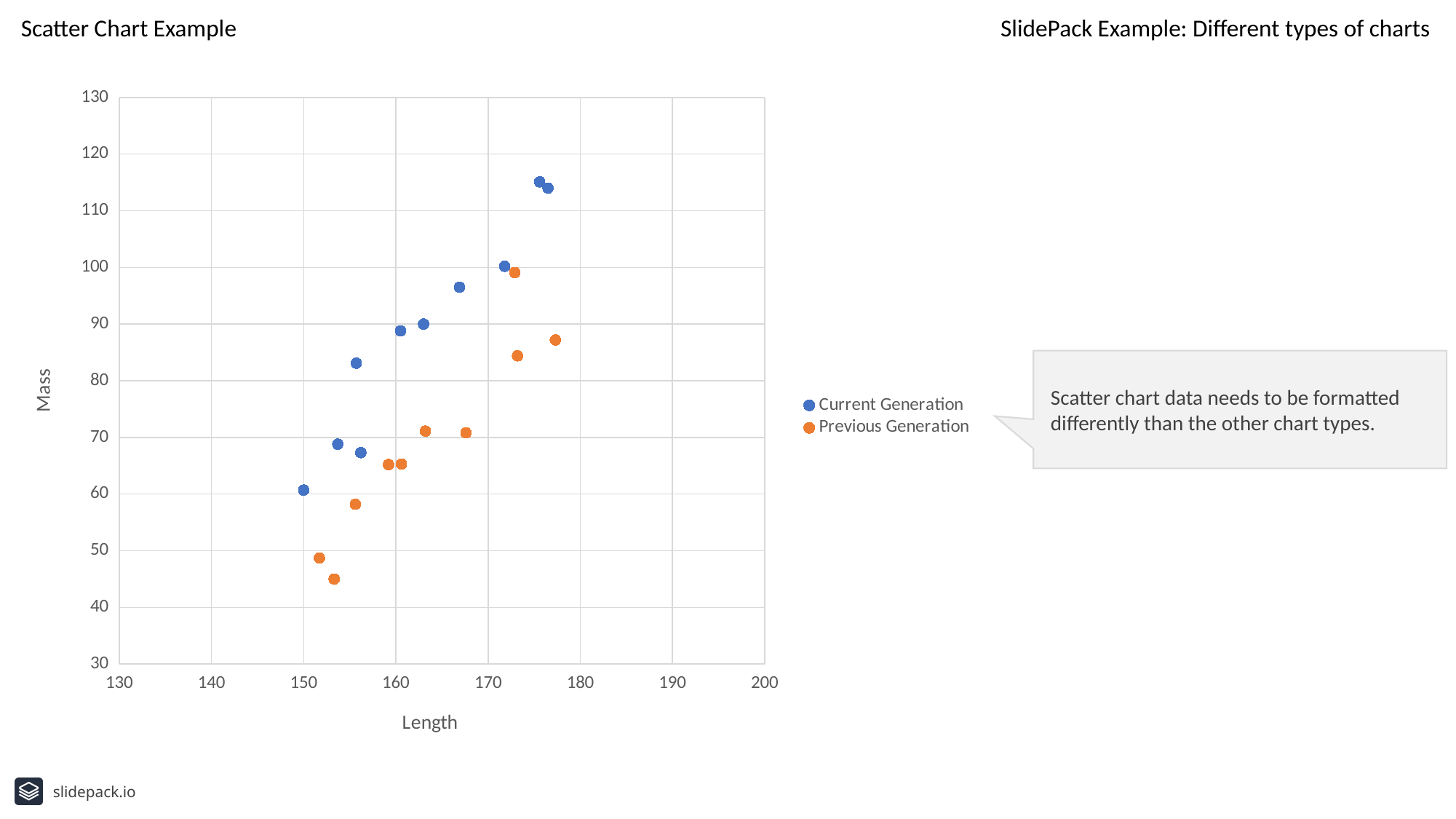
How many series does the legend list? 2 Which series contains the point with the highest Mass value? Current Generation Is the Mass of the highest Current Generation point greater or less than 110? greater How many Previous Generation points are plotted? 10 What kind of chart is shown on the slide? Scatter chart Is the Mass of the lowest Previous Generation point greater or less than 50? less Which series contains the point with the lowest Mass value? Previous Generation Is the Mass of the lowest Current Generation point greater or less than 70? less Does Mass generally rise or fall as Length increases in this chart? rise What are the two series named in the legend? Current Generation and Previous Generation How many Current Generation points are plotted? 10 What is the title of the chart? Scatter Chart Example